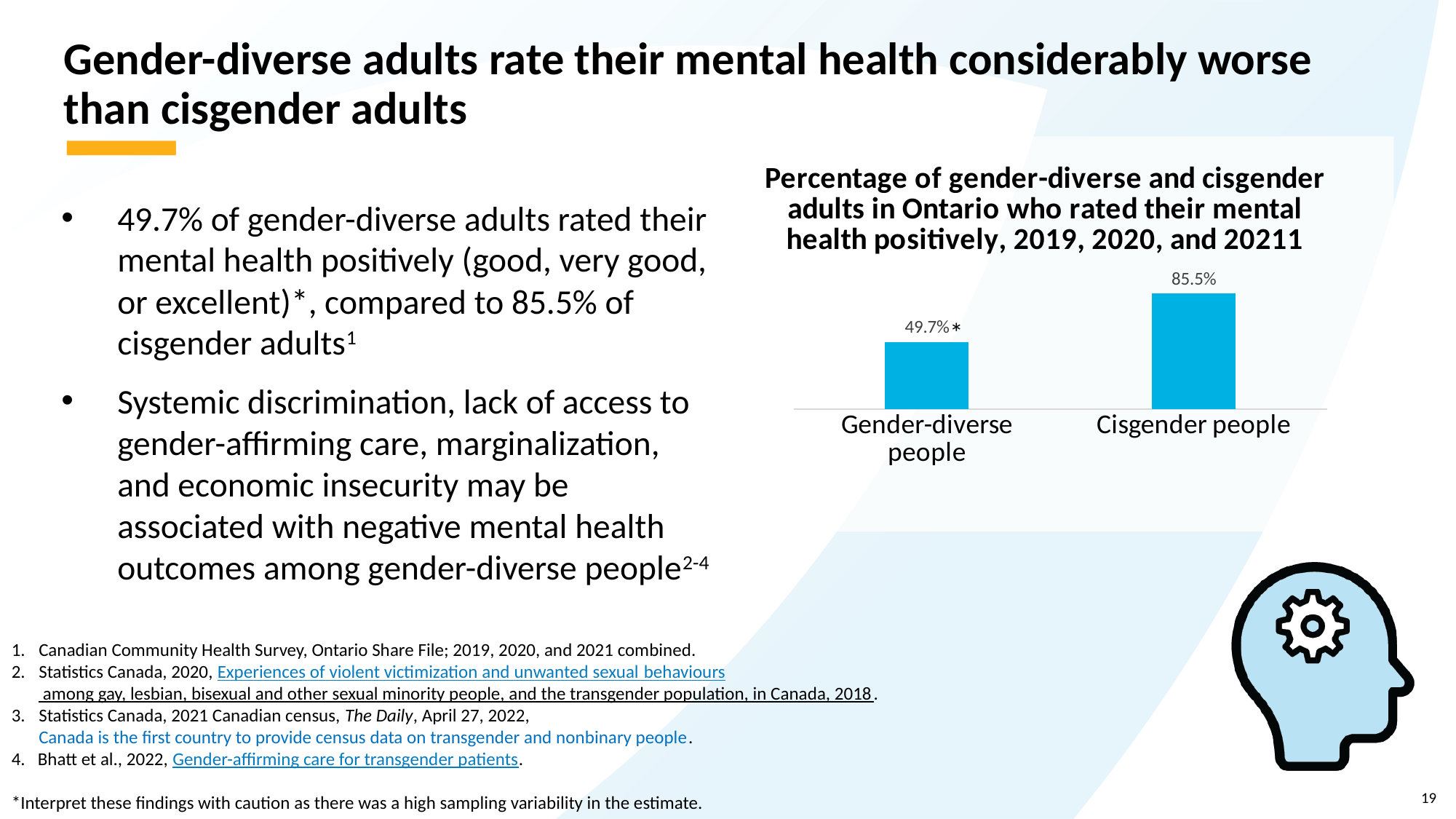
What percentage of gender-diverse people rated their mental health positively according to the chart? 49.7% Which group has the higher percentage in the chart? Cisgender people What percentage of cisgender people rated their mental health positively according to the chart? 85.5% What is the title of the chart? Percentage of gender-diverse and cisgender adults in Ontario who rated their mental health positively, 2019, 2020, and 2021 What is the difference in percentage points between cisgender people and gender-diverse people in the chart? 35.8 Which category's data label is marked with an asterisk in the chart? Gender-diverse people Which group has the lower percentage in the chart? Gender-diverse people How many categories are shown in the chart? 2 Is the value for gender-diverse people larger or smaller than the value for cisgender people? smaller What type of chart is shown on the slide? bar chart